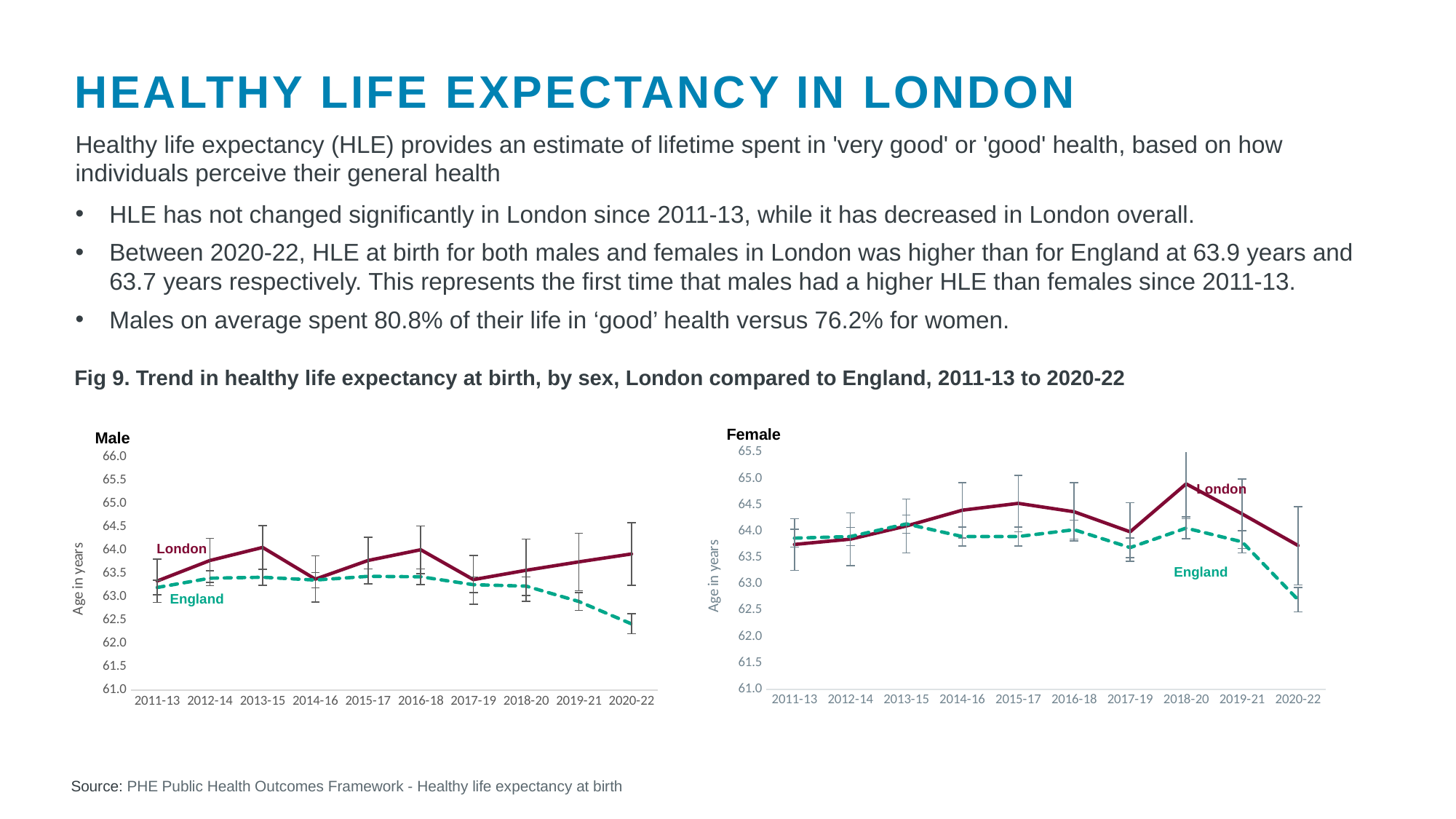
On the Male chart, is the value for London in 2020-22 greater or less than 63.5? greater On the Male chart, does the England line rise or fall from 2016-18 to 2020-22? fall On the Female chart, in which period is the London value highest? 2018-20 How many series are plotted on the Male chart? 2 On the Male chart, which series has the higher value in 2020-22, London or England? London How many time periods are shown on the x axis of the Female chart? 10 On the Female chart, is the value for England in 2020-22 greater or less than 63.0? less On the Male chart, is the value for England in 2020-22 greater or less than 63.0? less What is the label on the y axis of the Female chart? Age in years What kind of chart is the Male chart? line chart On the Male chart, in which period is the England value lowest? 2020-22 On the Female chart, does the London line rise or fall from 2018-20 to 2020-22? fall